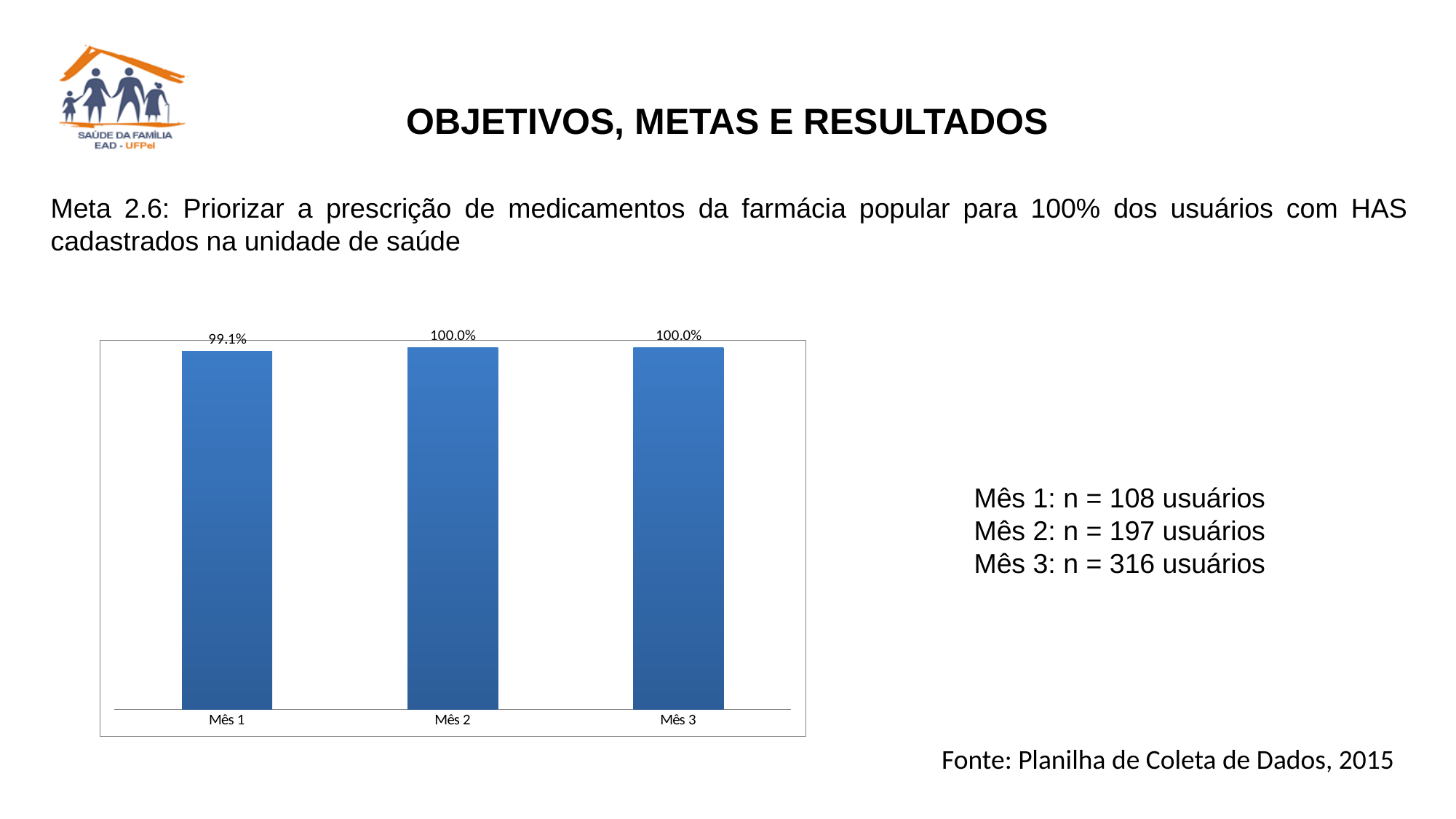
What kind of chart is shown on the slide? Bar chart What is the value for Mês 1? 99.1% How many categories are shown on the chart? 3 What is the difference between the values for Mês 2 and Mês 1? 0.9% Which month has the lowest value? Mês 1 Do the values rise or fall from Mês 1 to Mês 2? Rise Which is larger, the value for Mês 1 or the value for Mês 3? Mês 3 Do Mês 2 and Mês 3 have the same value? Yes What colour are the bars in the chart? Blue What is the label of the first category on the x axis? Mês 1 What is the value for Mês 2? 100.0% What is the value for Mês 3? 100.0%